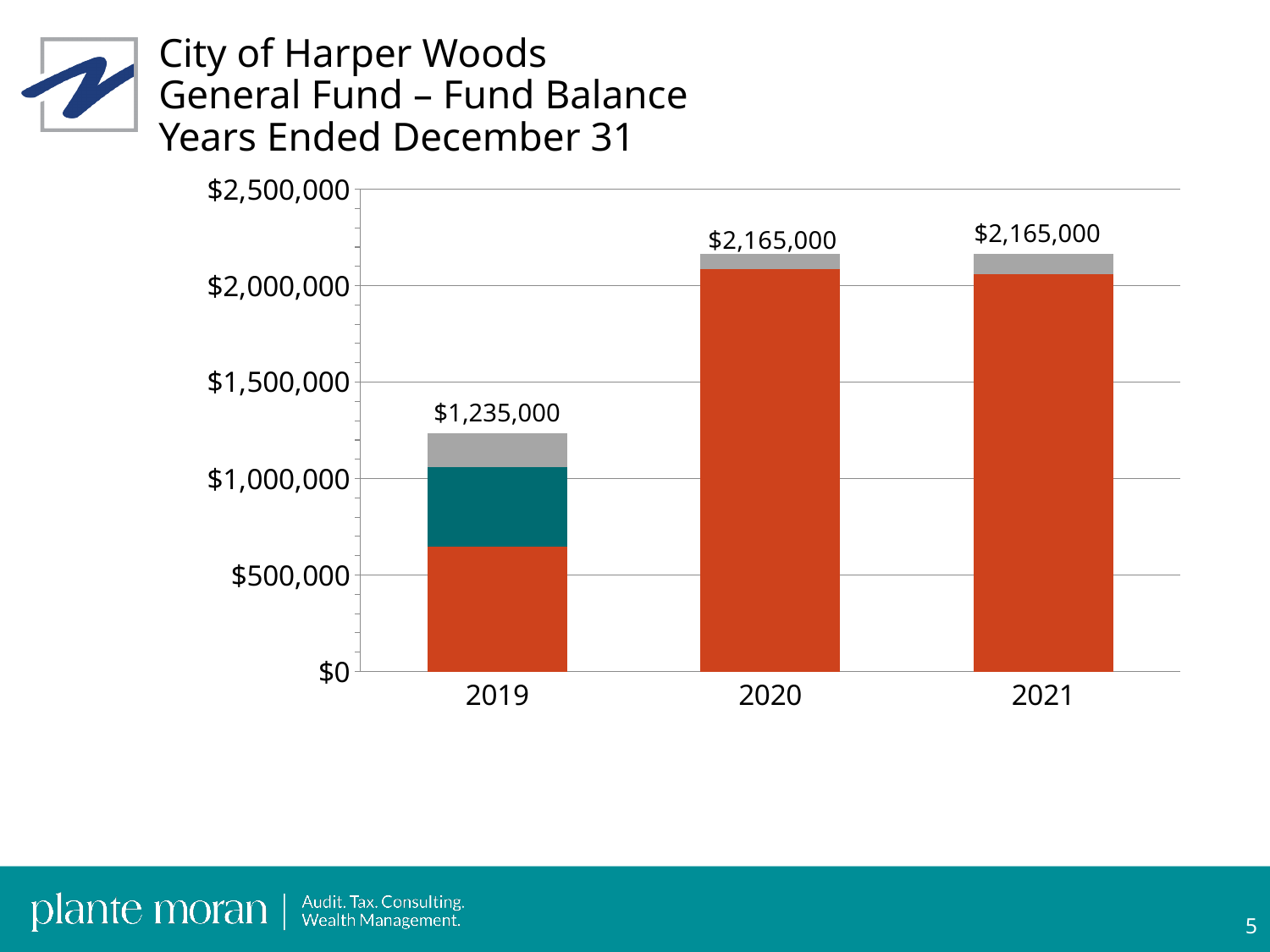
Which year has the lowest total fund balance? 2019 Is the orange segment of the 2019 bar greater or less than $1,000,000? less What is the total fund balance shown for 2020? $2,165,000 What is the total fund balance shown for 2019? $1,235,000 How many years are shown on the x axis? 3 What kind of chart is shown on the slide? Stacked bar chart How many differently coloured segments make up the 2019 bar? 3 What is the difference between the total fund balance in 2020 and in 2019? $930,000 Are the total fund balances for 2020 and 2021 the same? Yes What is the total fund balance shown for 2021? $2,165,000 Which year has a larger total fund balance, 2019 or 2020? 2020 Does the total fund balance rise or fall from 2019 to 2020? Rise